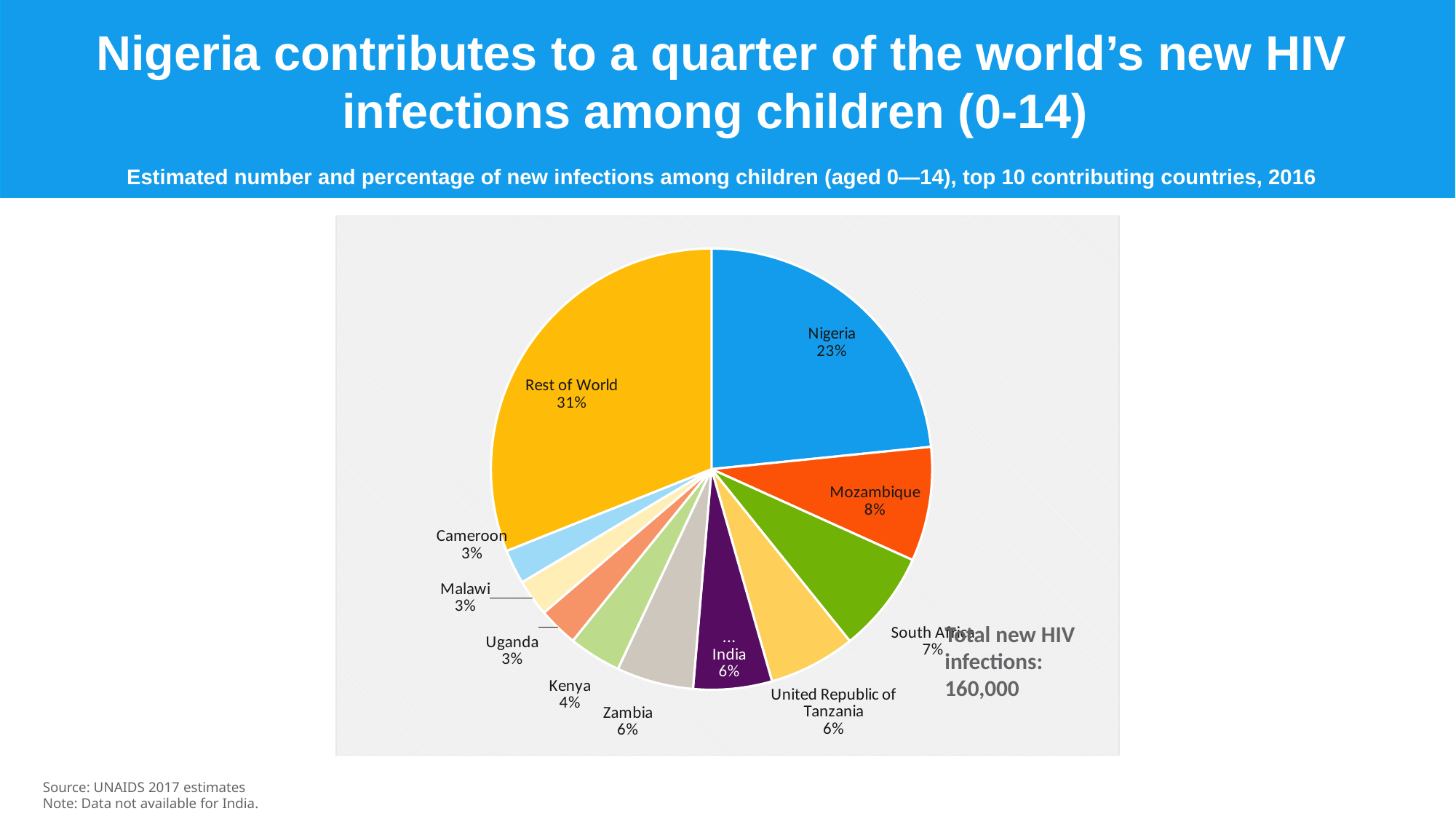
Which has the larger share, Mozambique or South Africa? Mozambique What is the share shown for Mozambique? 8% Which slice of the pie is the largest overall? Rest of World What is the difference in percentage points between Nigeria's share and Mozambique's share? 15% What is the total number of new HIV infections stated on the chart? 160,000 What kind of chart is shown on the slide? pie chart How many slices does the pie chart have? 11 What is the share shown for Kenya? 4% What percentage is shown for Rest of World? 31% What percentage of new HIV infections among children does Nigeria account for? 23% Which individual country has the largest slice of the pie? Nigeria What percentage is shown for the United Republic of Tanzania? 6%